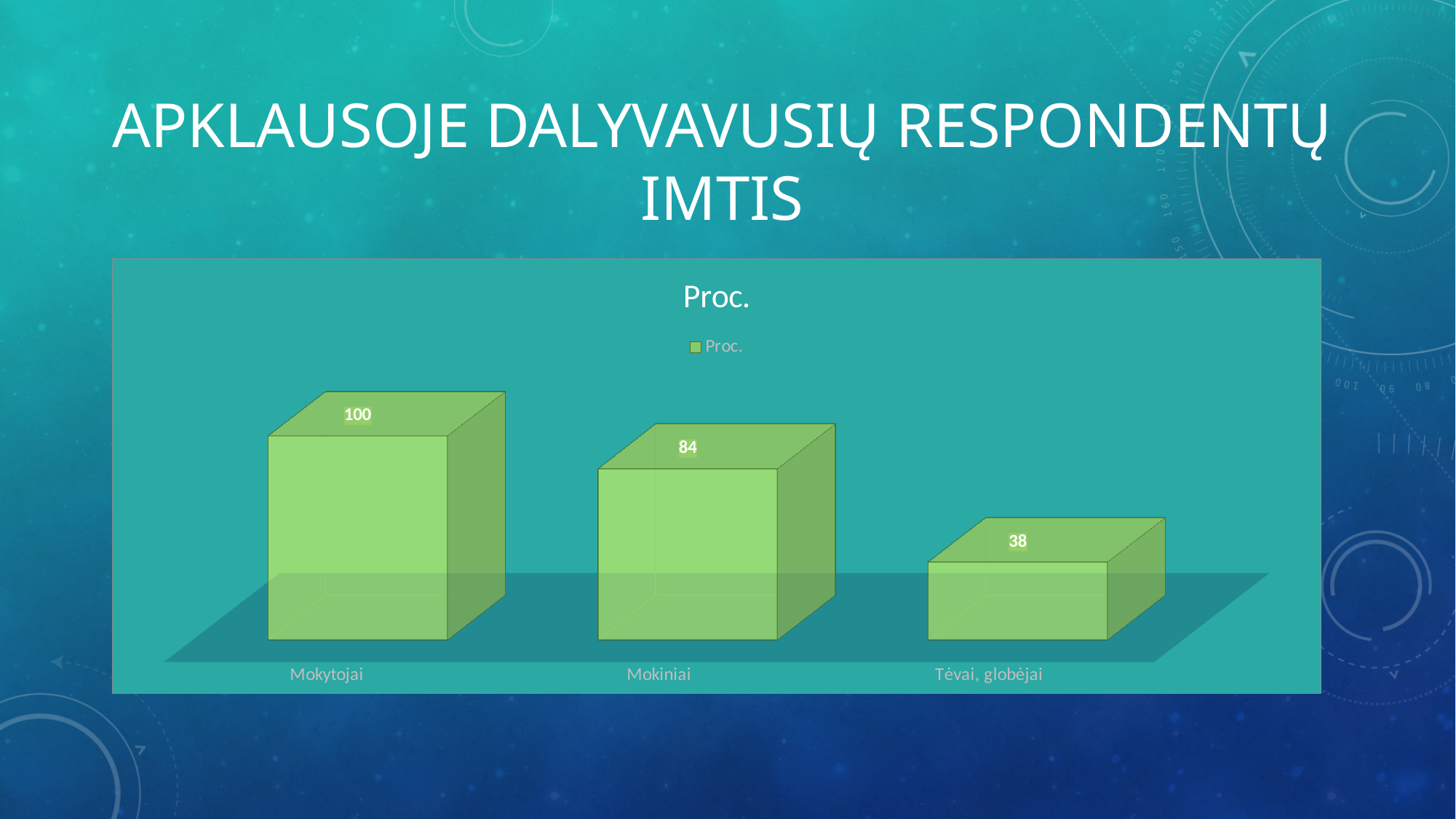
How many categories are shown in the chart? 3 What is the difference between the values for Mokytojai and Mokiniai? 16 What is the difference between the values for Mokiniai and Tėvai, globėjai? 46 What is the value for Mokiniai? 84 How many series does the legend list? 1 What is the title of the chart? Proc. Which category has the lowest value? Tėvai, globėjai What is the value for Tėvai, globėjai? 38 What kind of chart is shown on the slide? bar chart Which is larger, the value for Mokiniai or the value for Tėvai, globėjai? Mokiniai What is the value for Mokytojai? 100 Which category has the highest value? Mokytojai